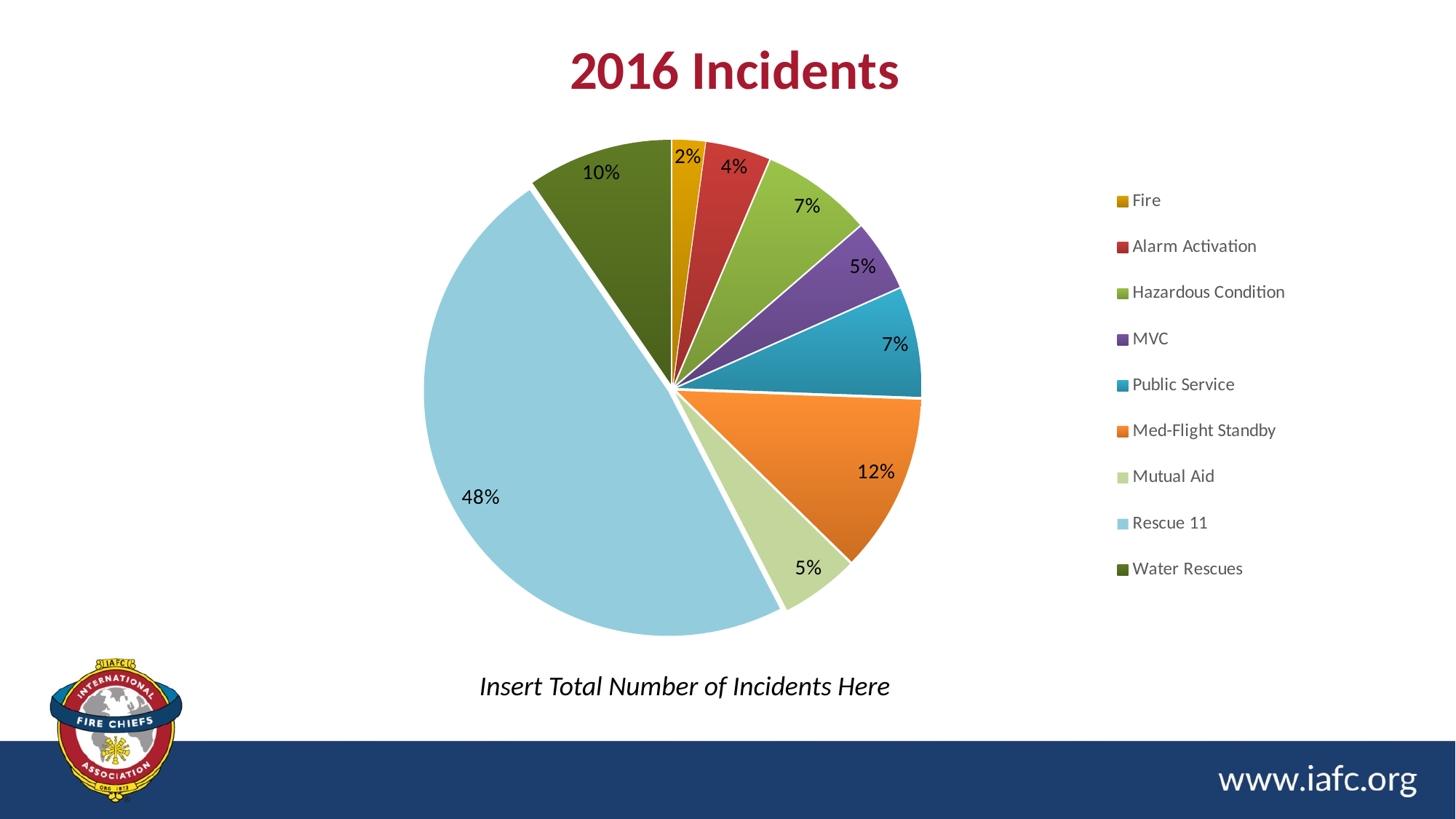
What share of the pie is Water Rescues? 10% What is the difference between the Rescue 11 share and the Med-Flight Standby share? 36% What is the title of the chart? 2016 Incidents How many categories does the legend list? 9 Which category has the largest slice? Rescue 11 What share of the pie is Rescue 11? 48% Which category has the smallest slice? Fire Which is larger, the Alarm Activation slice or the Water Rescues slice? Water Rescues What colour is the Rescue 11 slice? light blue What type of chart is shown on the slide? pie chart What share of the pie is Med-Flight Standby? 12%